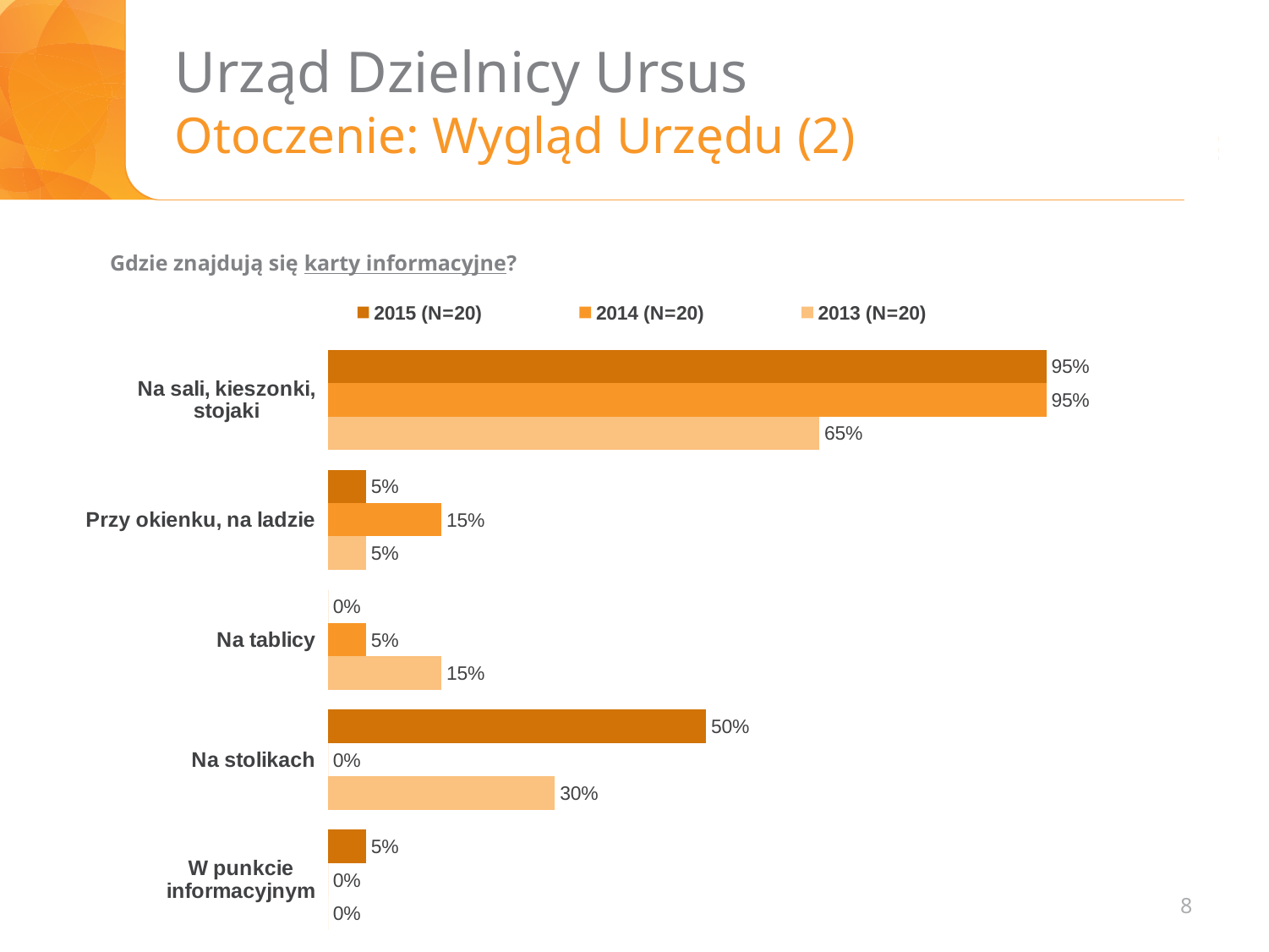
What is the value for 'Na stolikach' in the 2015 (N=20) series? 50% How many categories are shown on the chart? 5 What question is the chart answering, according to the text above it? Gdzie znajdują się karty informacyjne? What is the value for 'Na tablicy' in the 2013 (N=20) series? 15% Which category has the highest value in the 2015 (N=20) series? Na sali, kieszonki, stojaki How many series does the legend list? 3 What is the value for 'Przy okienku, na ladzie' in the 2014 (N=20) series? 15% What is the difference between the 2015 (N=20) and 2013 (N=20) values for 'Na stolikach'? 20% What kind of chart is shown on the slide? bar chart What is the value for 'Na sali, kieszonki, stojaki' in the 2013 (N=20) series? 65% Which is larger for 'Na tablicy': the 2014 (N=20) value or the 2013 (N=20) value? 2013 (N=20) What is the difference between the 2015 (N=20) and 2013 (N=20) values for 'Na sali, kieszonki, stojaki'? 30%